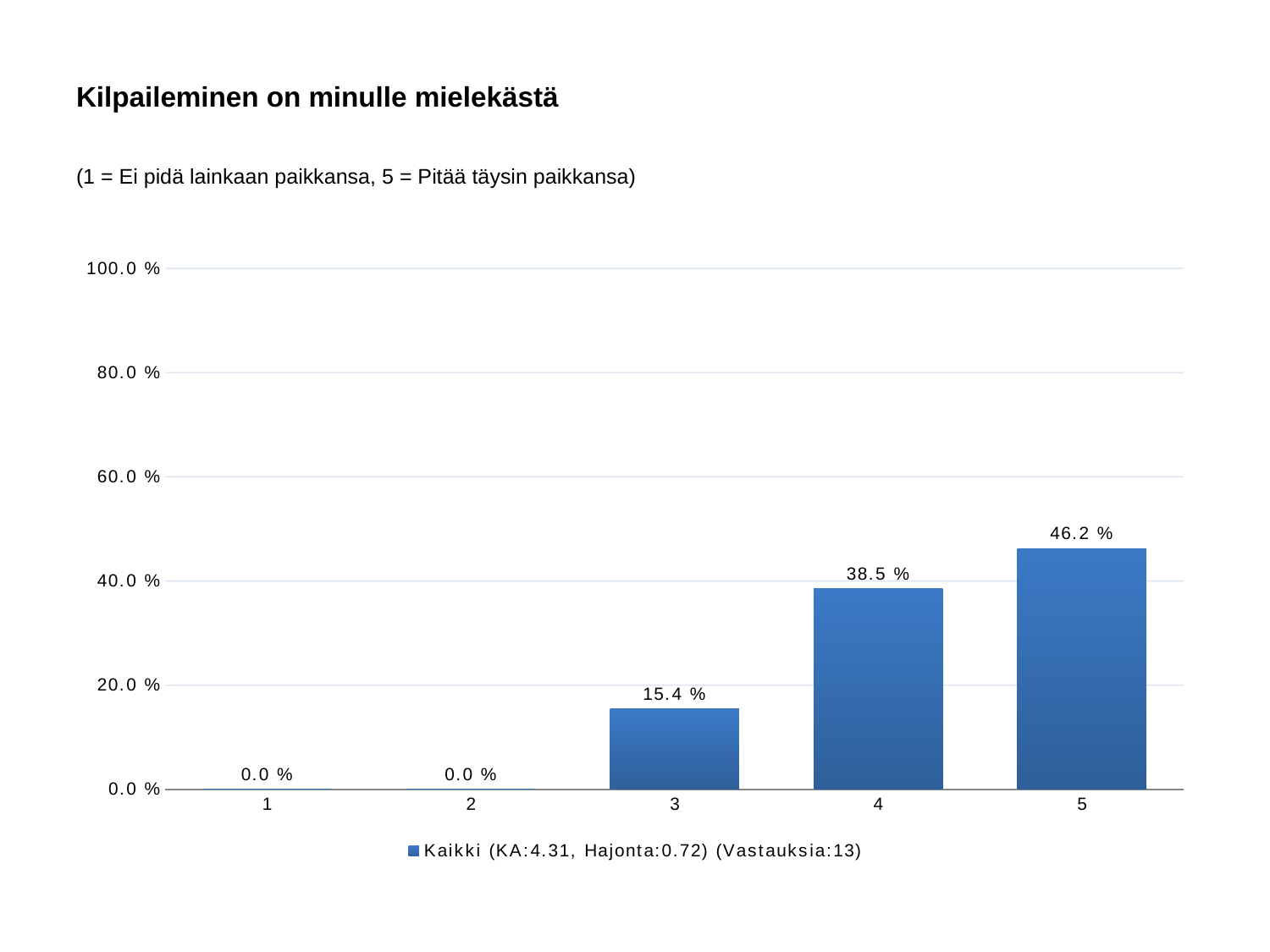
How many series does the legend list? 1 Which category has the highest value? 5 Do the values rise or fall from category 1 to category 5? rise What kind of chart is shown? bar chart What is the difference between the values for categories 5 and 4? 7.7 % What is the value for category 5? 46.2 % What is the title of the slide? Kilpaileminen on minulle mielekästä What is the value for category 4? 38.5 % How many categories are shown on the x axis? 5 What is the value for category 3? 15.4 % Is the value for category 5 greater or less than 40.0 %? greater Which is larger, the value for category 3 or the value for category 4? 4